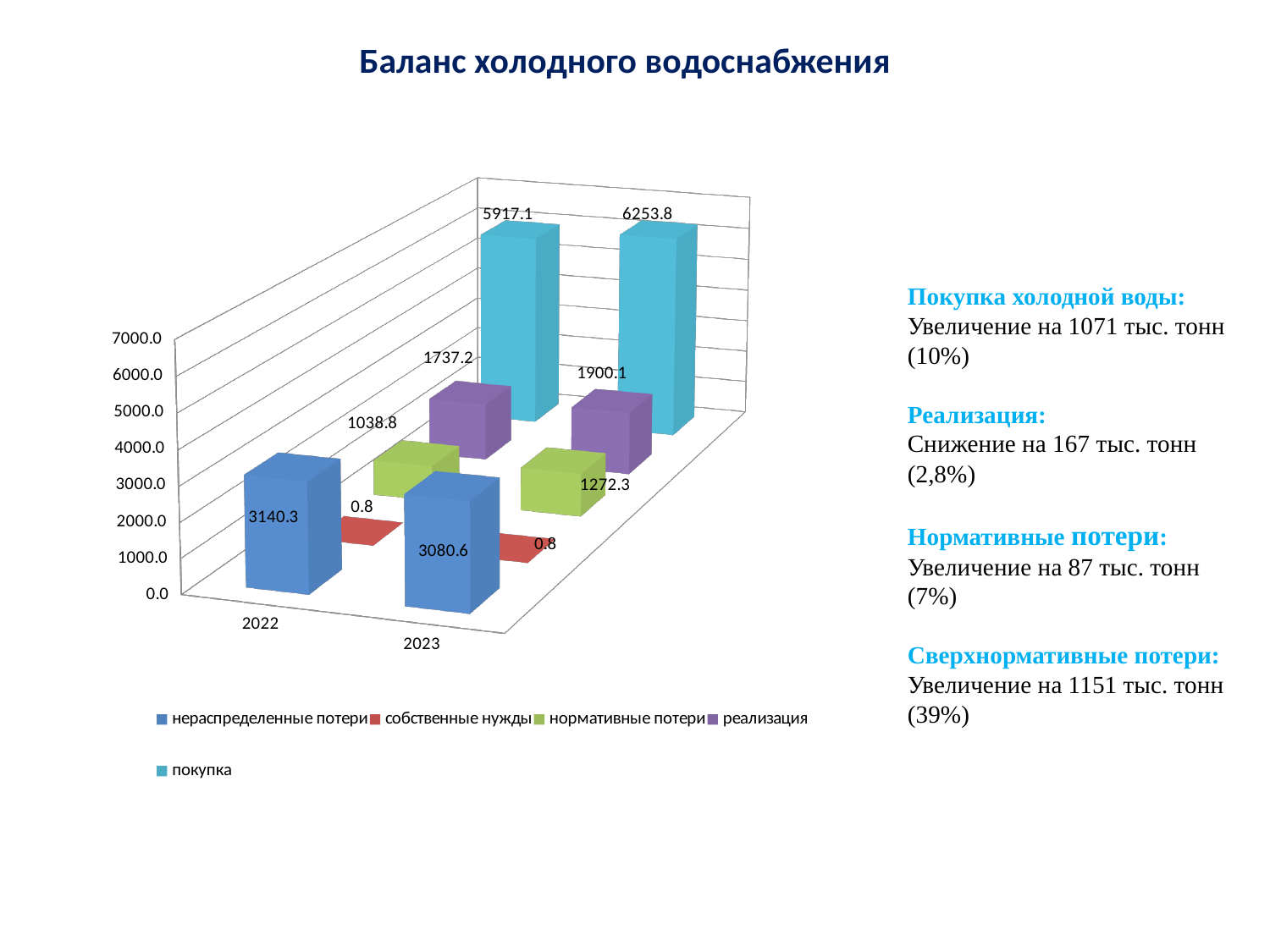
What is the title of the chart? Баланс холодного водоснабжения Which series has the highest value in 2023? покупка What is the value of собственные нужды for 2022? 0.8 How many years (categories) are shown on the x axis? 2 What is the value of покупка for 2022? 5917.1 How many series does the legend list? 5 What kind of chart is shown on the slide? bar chart What is the difference between the покупка values for 2023 and 2022? 336.7 Which year has the larger value for нераспределенные потери, 2022 or 2023? 2022 What is the value of покупка for 2023? 6253.8 What is the value of нераспределенные потери for 2023? 3080.6 Which series has the lowest value in 2022? собственные нужды